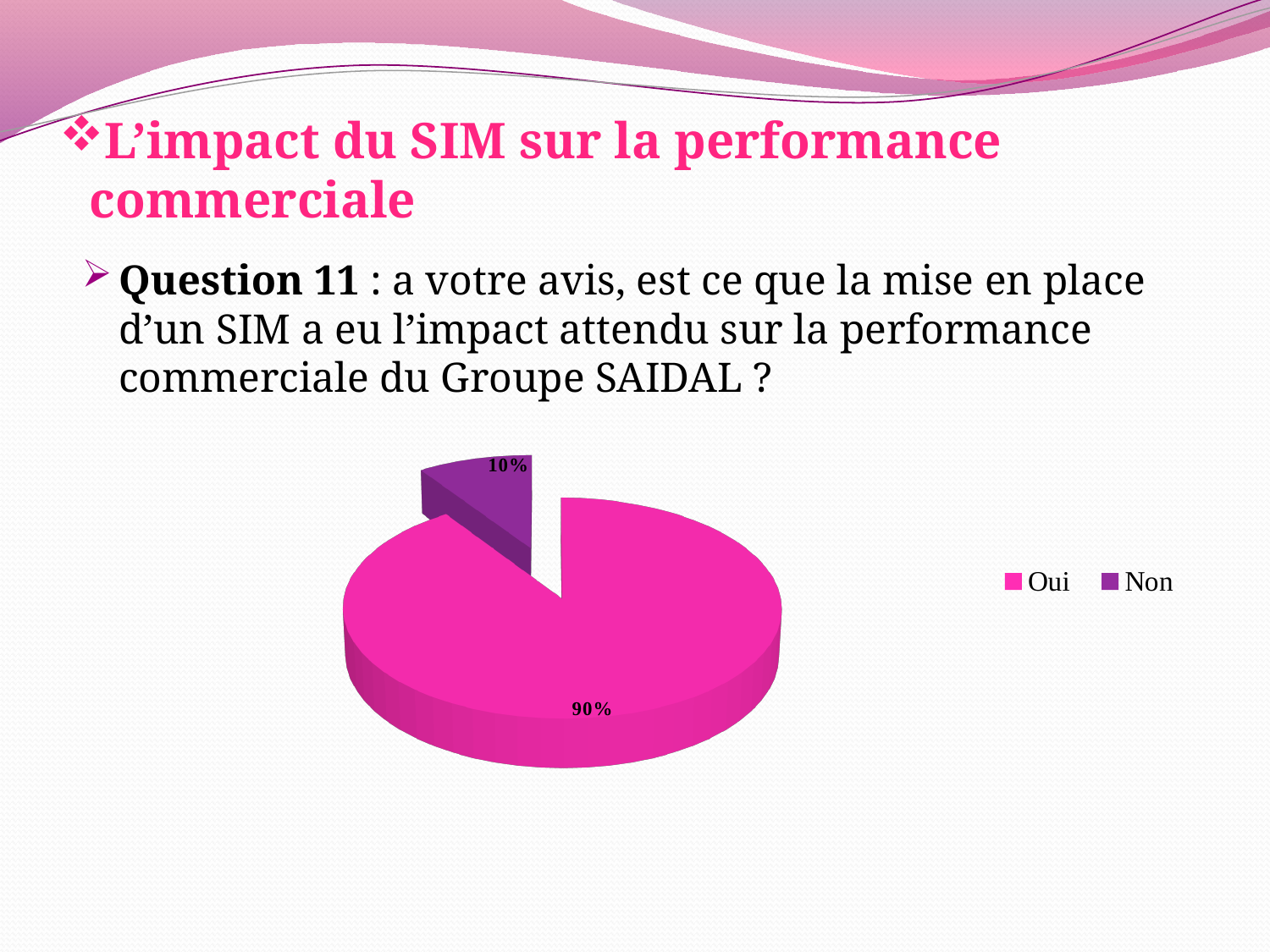
What kind of chart is shown on the slide? pie chart What is the difference in percentage points between the "Oui" and "Non" slices? 80 Which slice of the pie is the largest? Oui Which is larger, the "Oui" slice or the "Non" slice? Oui What percentage of the pie is labelled "Non"? 10% What percentage of the pie is labelled "Oui"? 90% How many slices does the pie chart have? 2 What colour is the "Oui" slice in the pie chart? pink What are the two legend entries of the pie chart? Oui and Non What share of the pie does the "Non" slice represent? 10% How many entries does the legend list? 2 Which slice of the pie is the smallest? Non